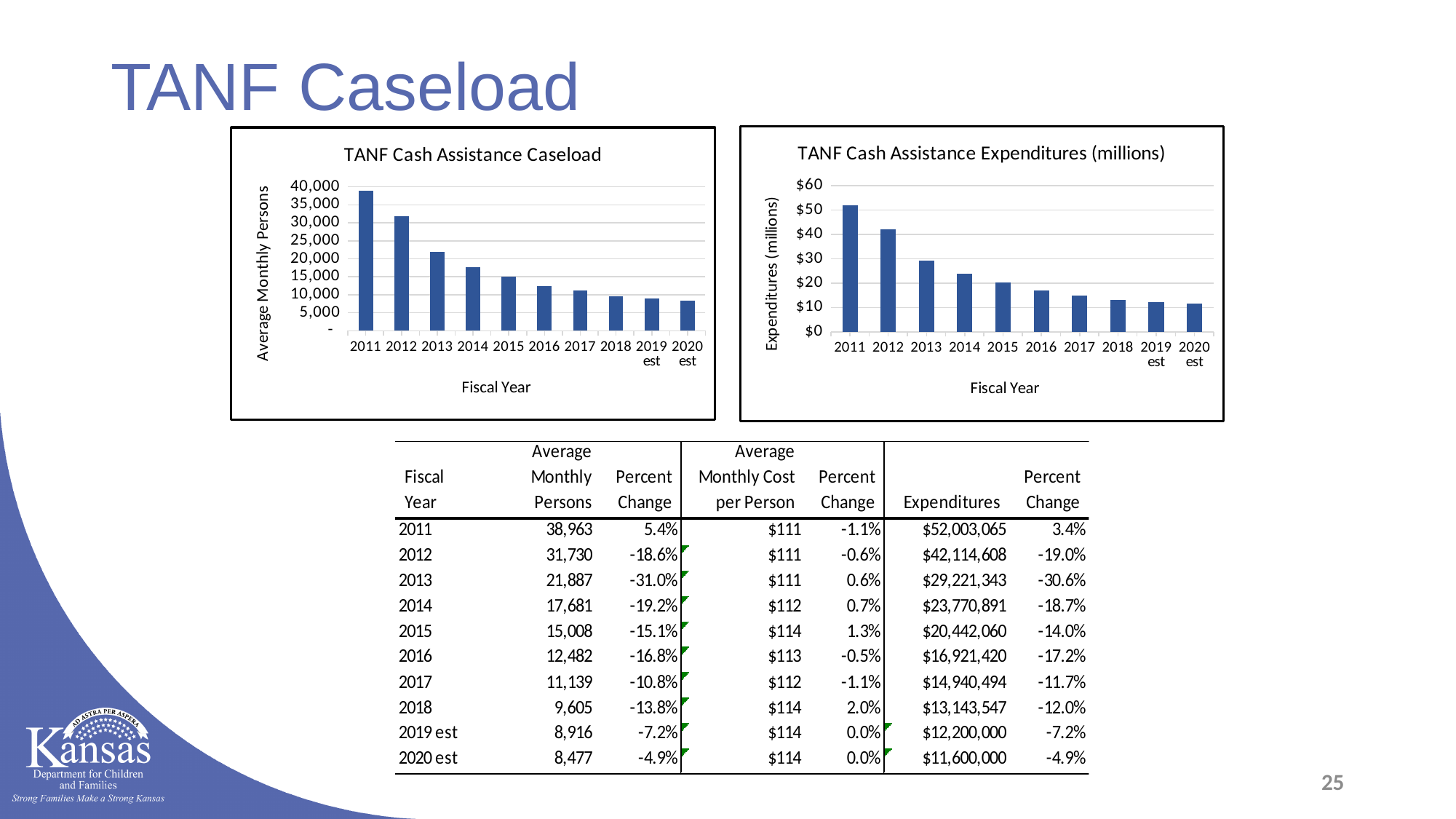
On the TANF Cash Assistance Caseload chart, do the values rise or fall from 2011 to 2020 est? fall On the TANF Cash Assistance Expenditures (millions) chart, is the value for 2018 greater or less than $20? less On the TANF Cash Assistance Caseload chart, which fiscal year has the lowest average monthly persons? 2020 est What is the x-axis title on the TANF Cash Assistance Expenditures (millions) chart? Fiscal Year On the TANF Cash Assistance Caseload chart, which fiscal year has the highest average monthly persons? 2011 What kind of chart is the TANF Cash Assistance Caseload chart? bar chart According to the table below the charts, what is the average monthly persons value for fiscal year 2011 shown on the TANF Cash Assistance Caseload chart? 38,963 On the TANF Cash Assistance Caseload chart, is the value for 2016 greater or less than 15,000? less On the TANF Cash Assistance Expenditures (millions) chart, which is larger, the value for 2012 or the value for 2013? 2012 On the TANF Cash Assistance Expenditures (millions) chart, is the value for 2011 greater or less than $50? greater How many fiscal years are plotted on the TANF Cash Assistance Caseload chart? 10